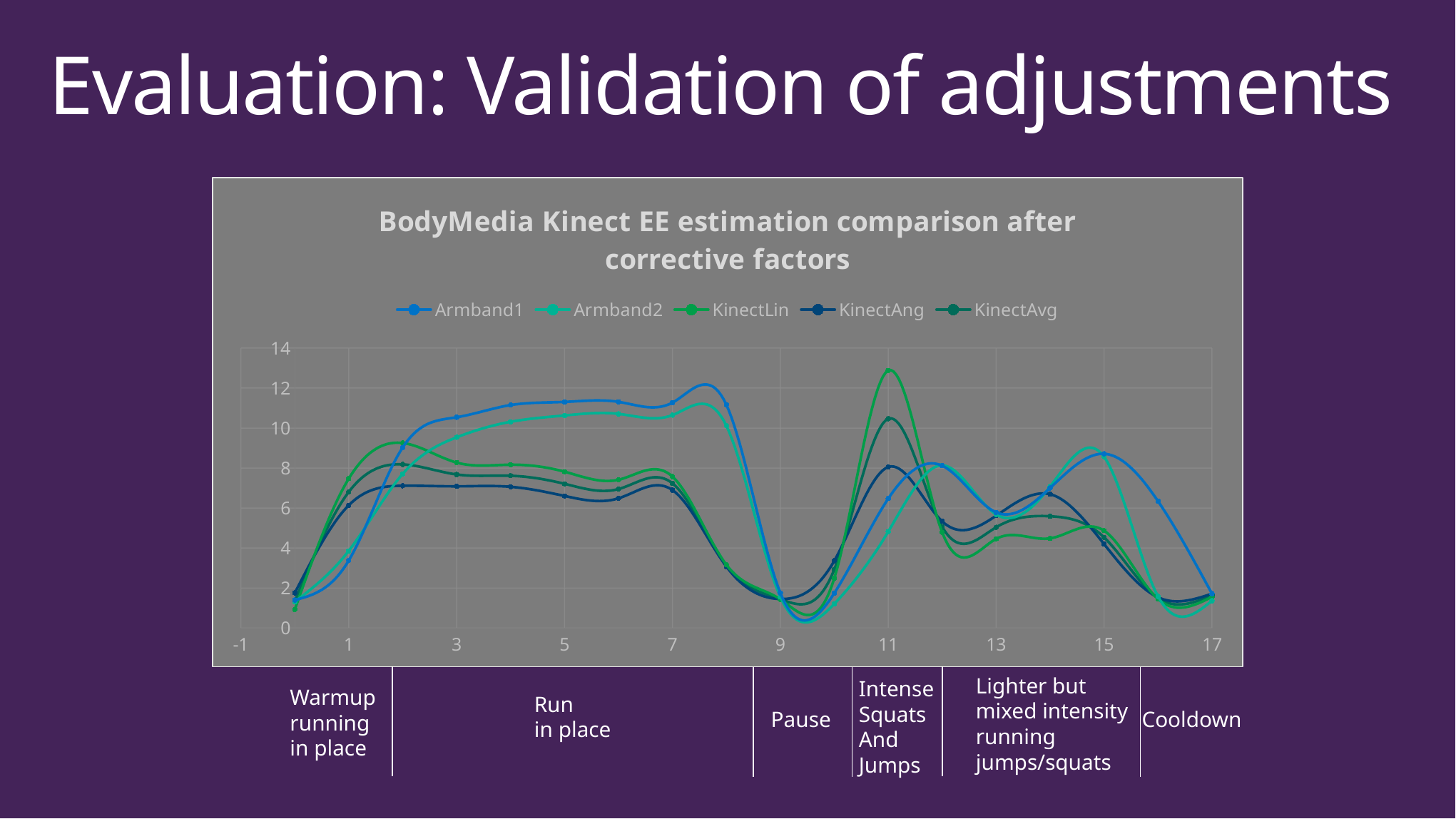
Does the Armband1 series rise or fall between x = 8 and x = 9? fall At x = 5, which is larger: Armband1 or KinectAng? Armband1 Is the value for Armband1 at x = 5 greater or less than 10? greater Is the value for KinectLin at x = 11 greater or less than 12? greater What is the title of the chart? BodyMedia Kinect EE estimation comparison after corrective factors Is the value for KinectAng at x = 5 greater or less than 8? less Which series has the highest value at x = 11? KinectLin Which series has the lowest value at x = 5? KinectAng Which series has the highest value at x = 5? Armband1 How many series does the legend list? 5 What kind of chart is shown on the slide? line chart Which series is listed first in the legend? Armband1